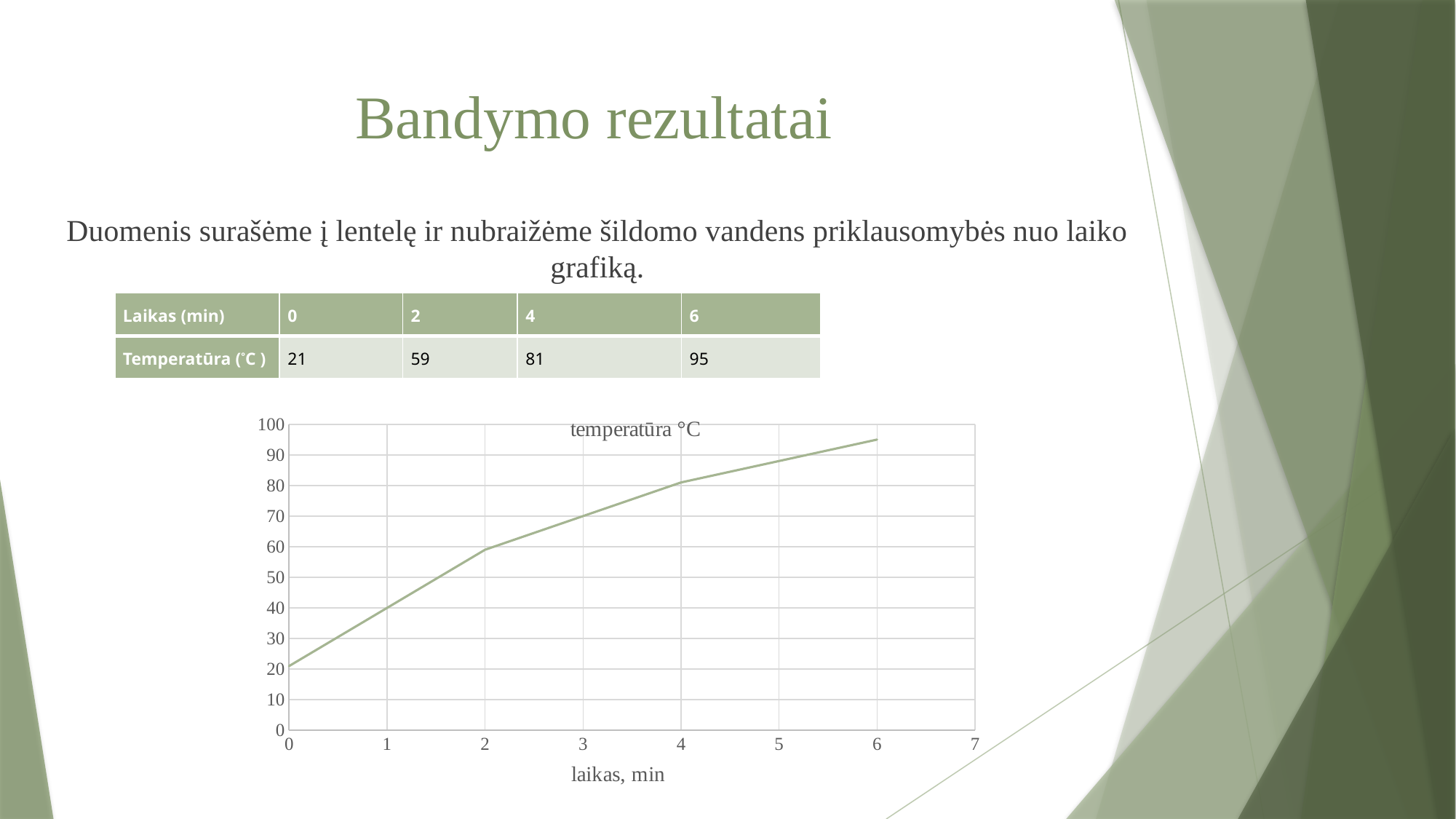
What is the temperature at 2 min? 59 What is the difference between the temperature at 6 min and at 0 min? 74 What is the label of the x axis of the chart? laikas, min What is the temperature at 0 min? 21 What is the title of the chart? temperatūra °C Does the temperature rise or fall as time increases? rise What type of chart is shown on the slide? line chart How many data points are plotted on the chart? 4 At which time is the temperature lowest? 0 min At which time is the temperature highest? 6 min What is the temperature at 6 min? 95 What is the temperature at 4 min? 81